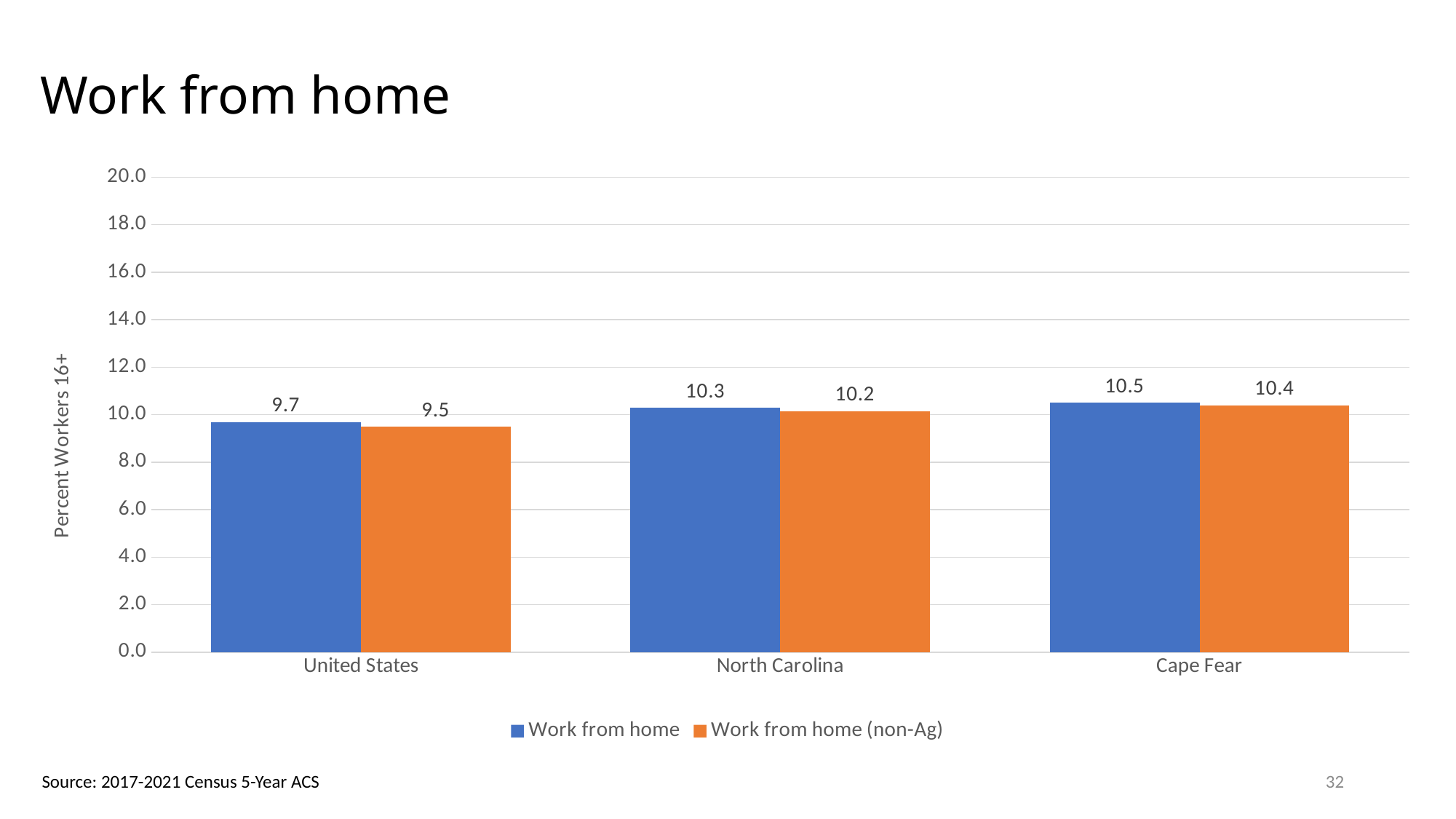
Which is larger: the 'Work from home' value for North Carolina or for United States? North Carolina How many series does the legend list? 2 Which category has the lowest 'Work from home (non-Ag)' value? United States What is the difference between the 'Work from home' values for Cape Fear and United States? 0.8 What is the 'Work from home (non-Ag)' value for North Carolina? 10.2 What is the 'Work from home' value for Cape Fear? 10.5 Which category has the highest 'Work from home' value? Cape Fear What is the 'Work from home' value for United States? 9.7 How many categories are shown on the x axis? 3 What is the label of the vertical axis? Percent Workers 16+ What is the 'Work from home (non-Ag)' value for United States? 9.5 What kind of chart is shown on the slide? Bar chart